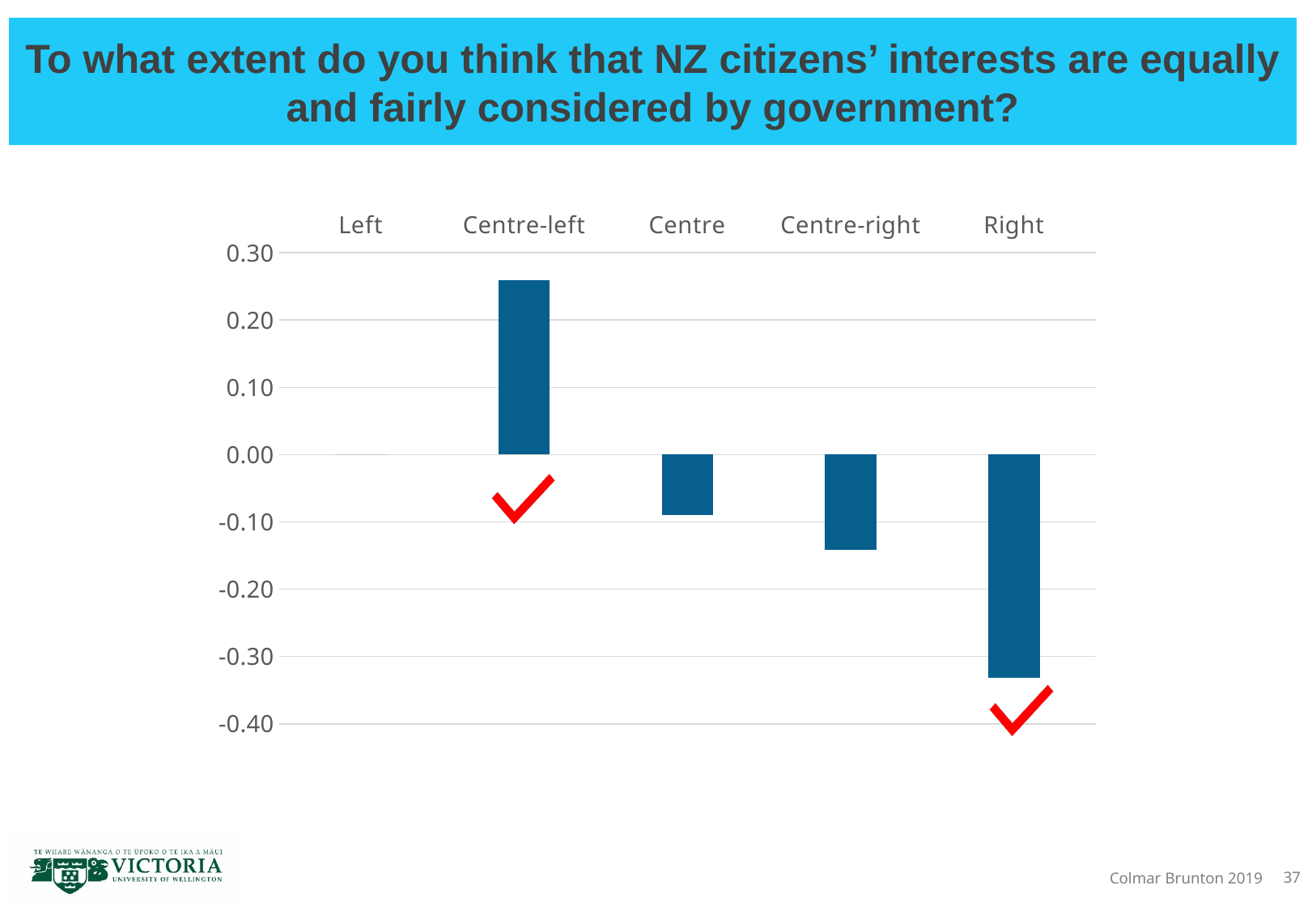
Which two categories are marked with a red tick on the chart? Centre-left and Right Is the value for Right greater or less than -0.30? less What kind of chart is shown on the slide? bar chart Which category has the lowest value in the chart? Right Is the value for Centre greater or less than 0.00? less How many categories are shown on the x axis of the chart? 5 Do the values rise or fall moving from Centre-left to Right along the x axis? fall Which has the larger value, Centre-left or Right? Centre-left Which has the larger value, Centre or Centre-right? Centre Is the value for Centre-right greater or less than -0.10? less Which category has the highest value in the chart? Centre-left